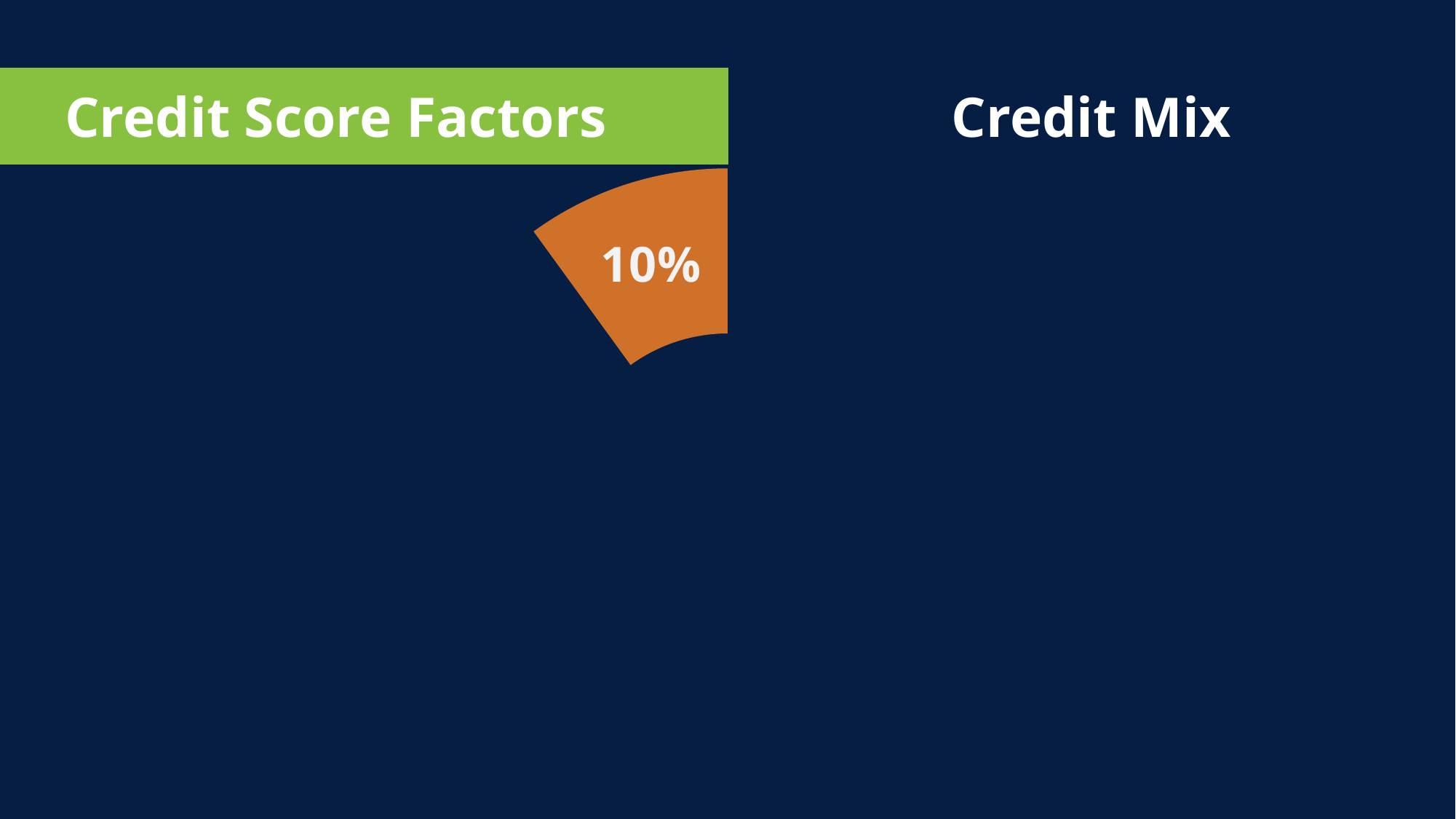
Which credit score factor is named on the slide next to the 10% slice? Credit Mix What share of the Credit Score Factors chart does the visible orange slice represent? 10% What is the title of the chart on this slide? Credit Score Factors What value is printed on the orange slice of the Credit Score Factors chart? 10% How many slices are visible in the Credit Score Factors chart on this slide? 1